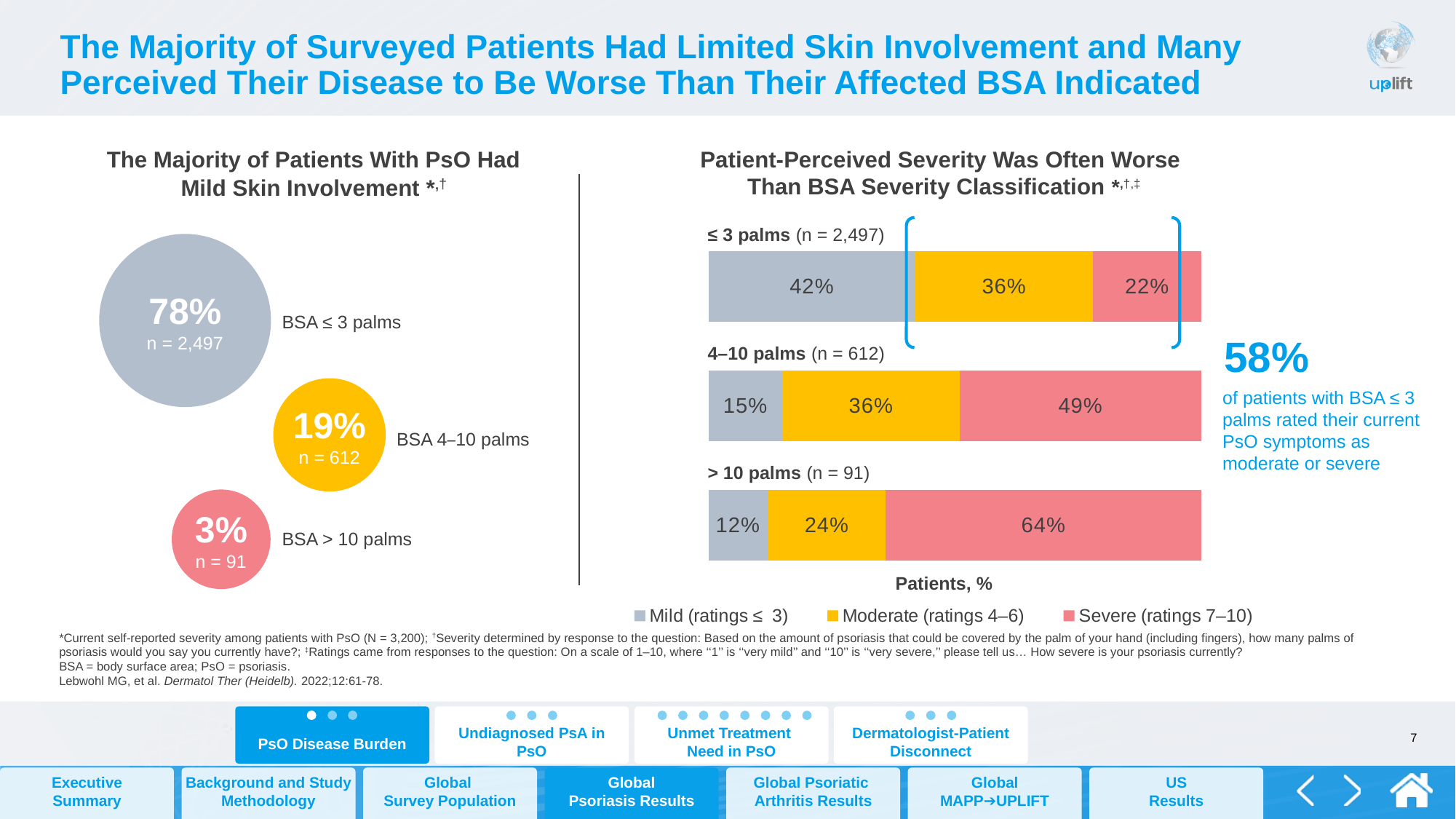
In the right chart, does the Severe share rise or fall as the number of palms increases from ≤ 3 to > 10? Rises In the right chart, what is the combined Moderate and Severe share for the ≤ 3 palms group? 58% In the left chart, what is the n for the BSA 4–10 palms group? 612 In the right chart, what percentage of patients with ≤ 3 palms rated their severity as Mild? 42% In the left chart (The Majority of Patients With PsO Had Mild Skin Involvement), what percentage of patients had BSA ≤ 3 palms? 78% What kind of chart is the right chart? Stacked bar chart In the right chart, for the 4–10 palms group, which is larger: the Moderate share or the Severe share? Severe In the right chart (Patient-Perceived Severity Was Often Worse Than BSA Severity Classification), what percentage of patients with > 10 palms rated their severity as Severe? 64% In the right chart, how many series does the legend list? 3 In the left chart, what is the difference in percentage points between the BSA ≤ 3 palms group and the BSA 4–10 palms group? 59 percentage points In the left chart, which BSA group has the smallest percentage of patients? BSA > 10 palms In the right chart, how many BSA groups (bars) are shown? 3